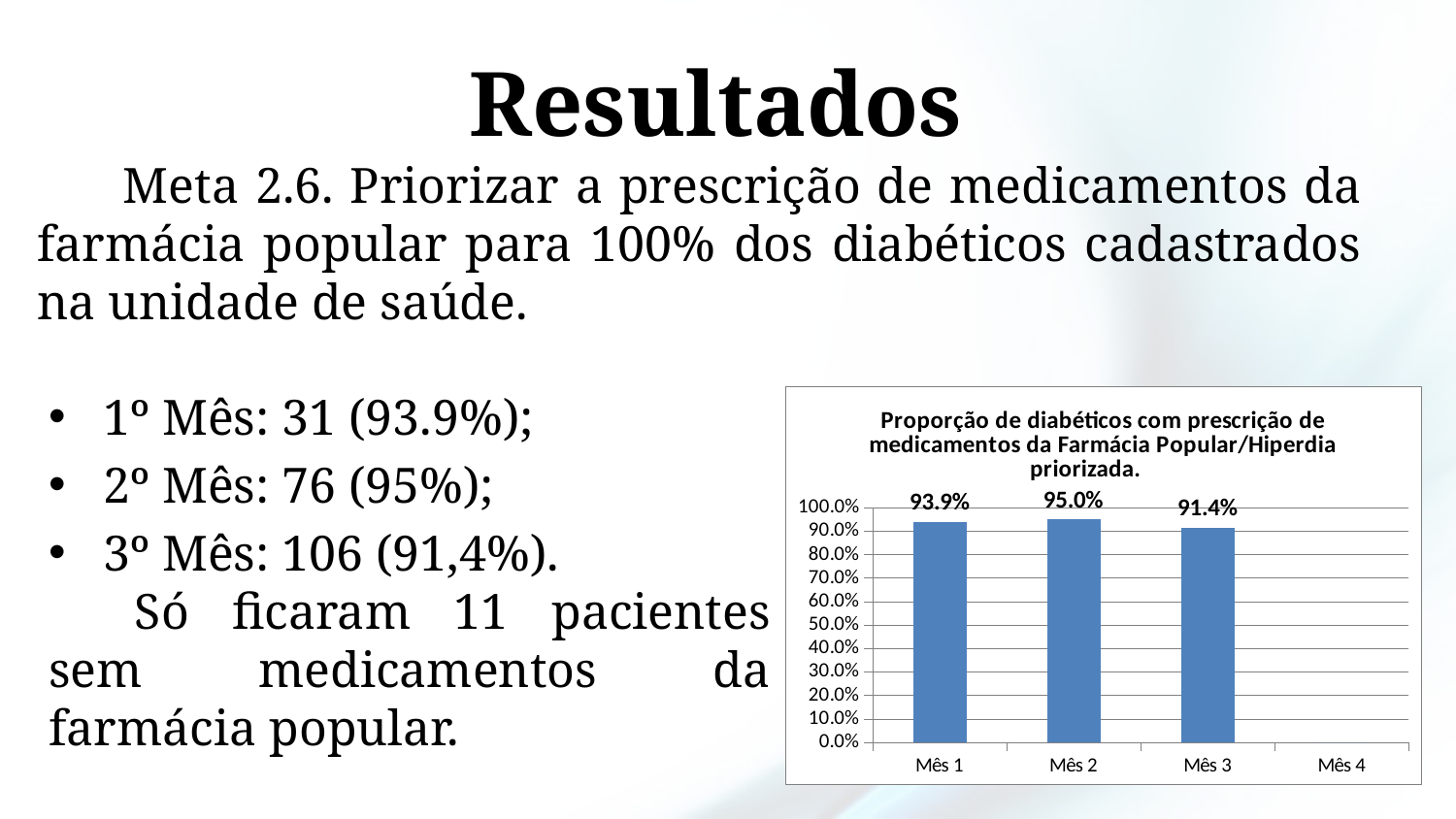
What is the value for Mês 2 in the chart? 95.0% What is the difference between the values for Mês 2 and Mês 1? 1.1 percentage points Which of the plotted months has the lowest value in the chart? Mês 3 Is the value for Mês 3 greater or less than 100.0%? less What is the value for Mês 3 in the chart? 91.4% What kind of chart is shown on the slide? Bar chart Which month has the highest value in the chart? Mês 2 Does the value rise or fall from Mês 2 to Mês 3? Fall What is the difference between the values for Mês 2 and Mês 3? 3.6 percentage points What is the value for Mês 1 in the chart? 93.9% Which is larger, the value for Mês 1 or the value for Mês 3? Mês 1 How many bars are plotted in the chart? 3